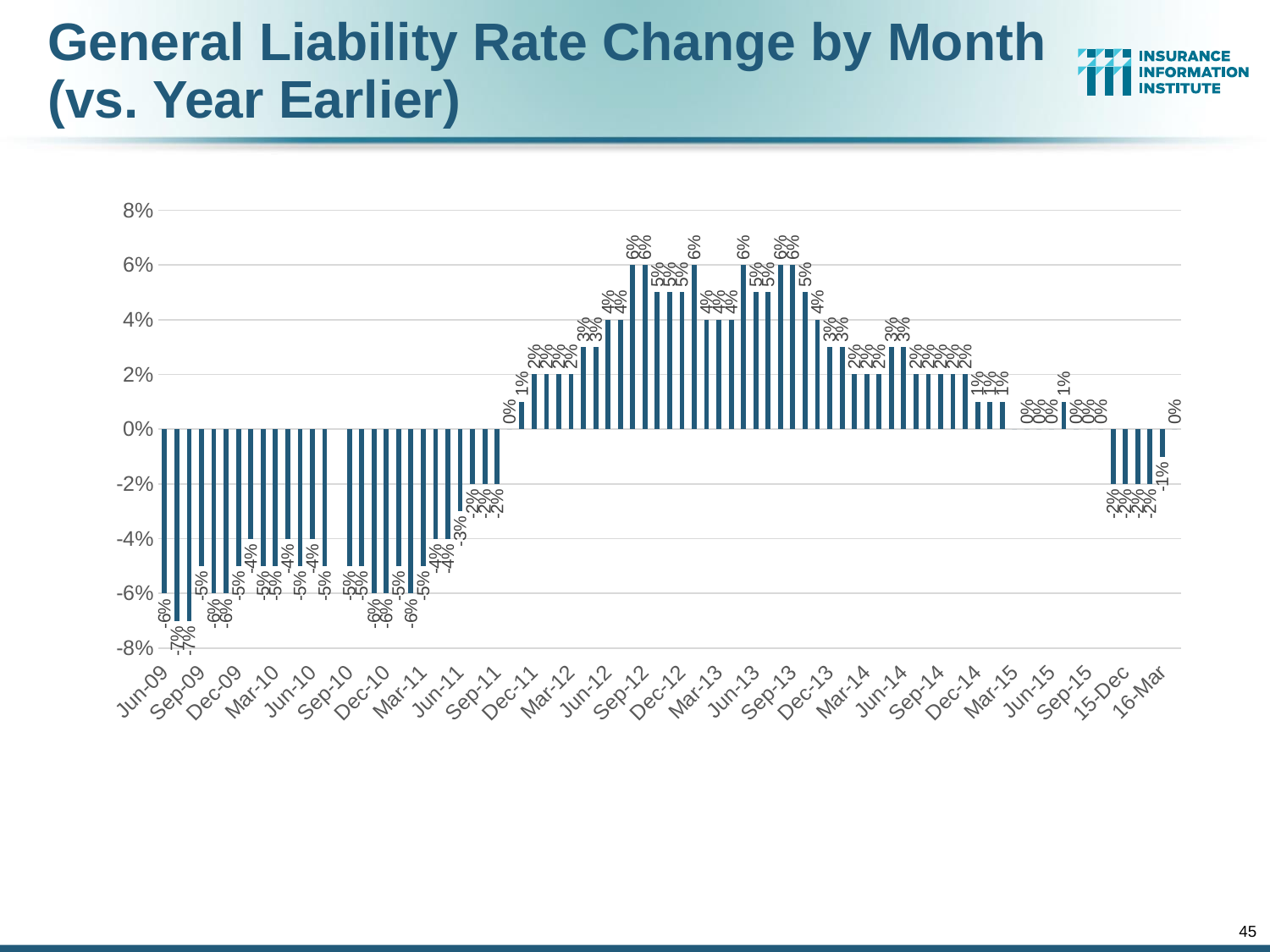
What are the minimum and maximum values shown on the vertical axis? -8% and 8% What is the rate change for Jun-09, the first month on the chart? -6% Which has the larger rate change, Jun-09 or 16-Mar? 16-Mar Do the rate changes generally rise or fall from Jun-09 to Sep-12? rise What is the highest rate change shown on the chart? 6% What is the lowest rate change shown on the chart? -7% What kind of chart is shown on the slide? bar chart What is the difference between the rate change for 16-Mar (-1%) and Jun-09 (-6%)? 5 percentage points Is the rate change for 15-Dec greater or less than 0%? less What is the rate change for 16-Mar, the last month on the chart? -1% What is the title of the chart? General Liability Rate Change by Month (vs. Year Earlier) Is the rate change for Jun-12 greater or less than 2%? greater